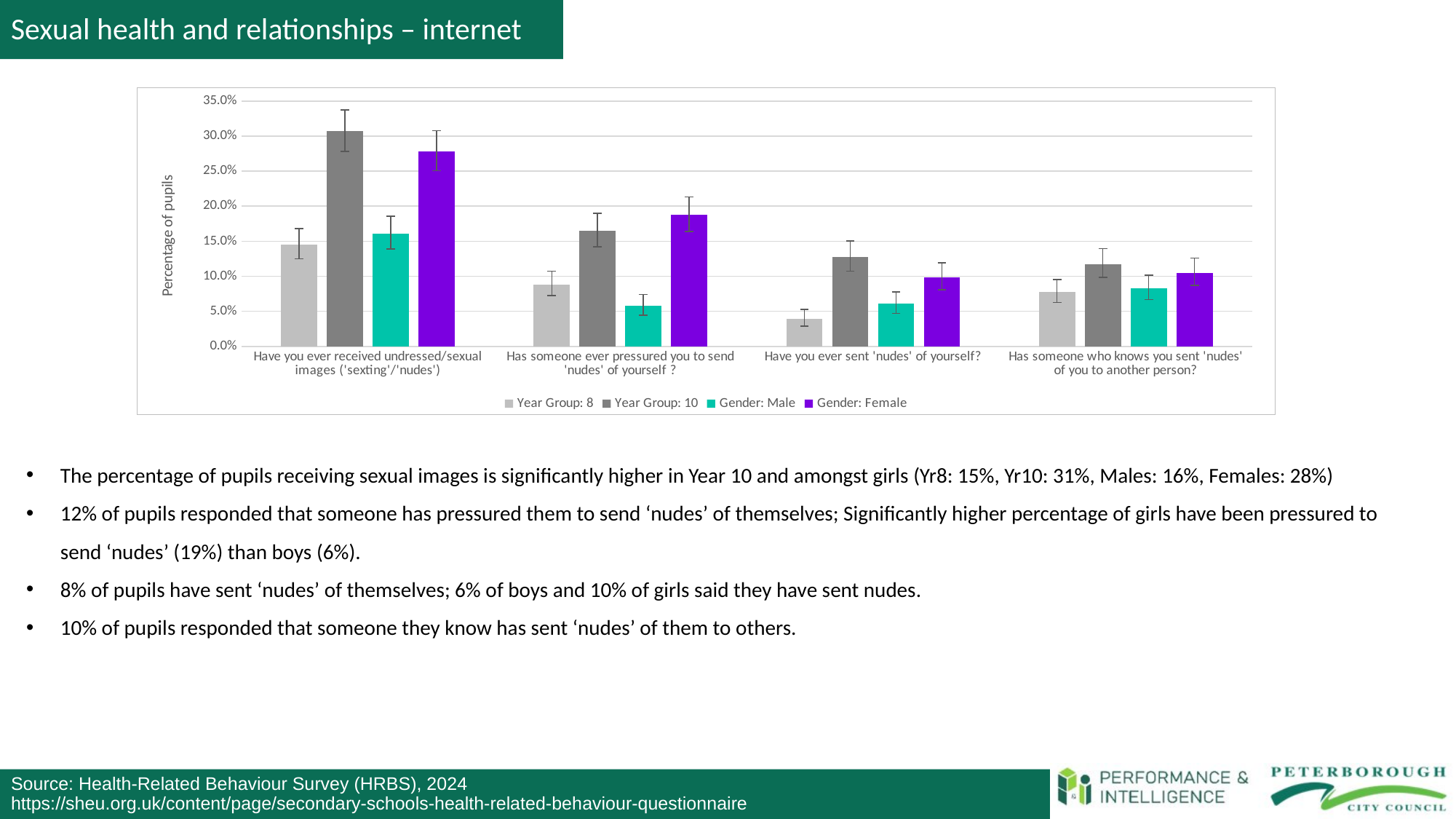
Which series has the highest value for 'Has someone ever pressured you to send 'nudes' of yourself ?'? Gender: Female How many question categories are shown along the x axis? 4 For 'Have you ever received undressed/sexual images', is the Year Group: 10 value greater or less than 25.0%? greater Which series has the lowest value for 'Have you ever sent 'nudes' of yourself?'? Year Group: 8 For 'Have you ever sent 'nudes' of yourself?', is the Year Group: 10 value greater or less than 10.0%? greater What is the label on the vertical axis of the chart? Percentage of pupils For 'Have you ever sent 'nudes' of yourself?', is the Year Group: 8 value greater or less than 5.0%? less Which series has the highest value for 'Have you ever received undressed/sexual images ('sexting'/'nudes')'? Year Group: 10 For 'Has someone ever pressured you to send 'nudes' of yourself ?', which is larger: Year Group: 8 or Gender: Male? Year Group: 8 What kind of chart is shown on the slide? bar chart How many series does the legend list? 4